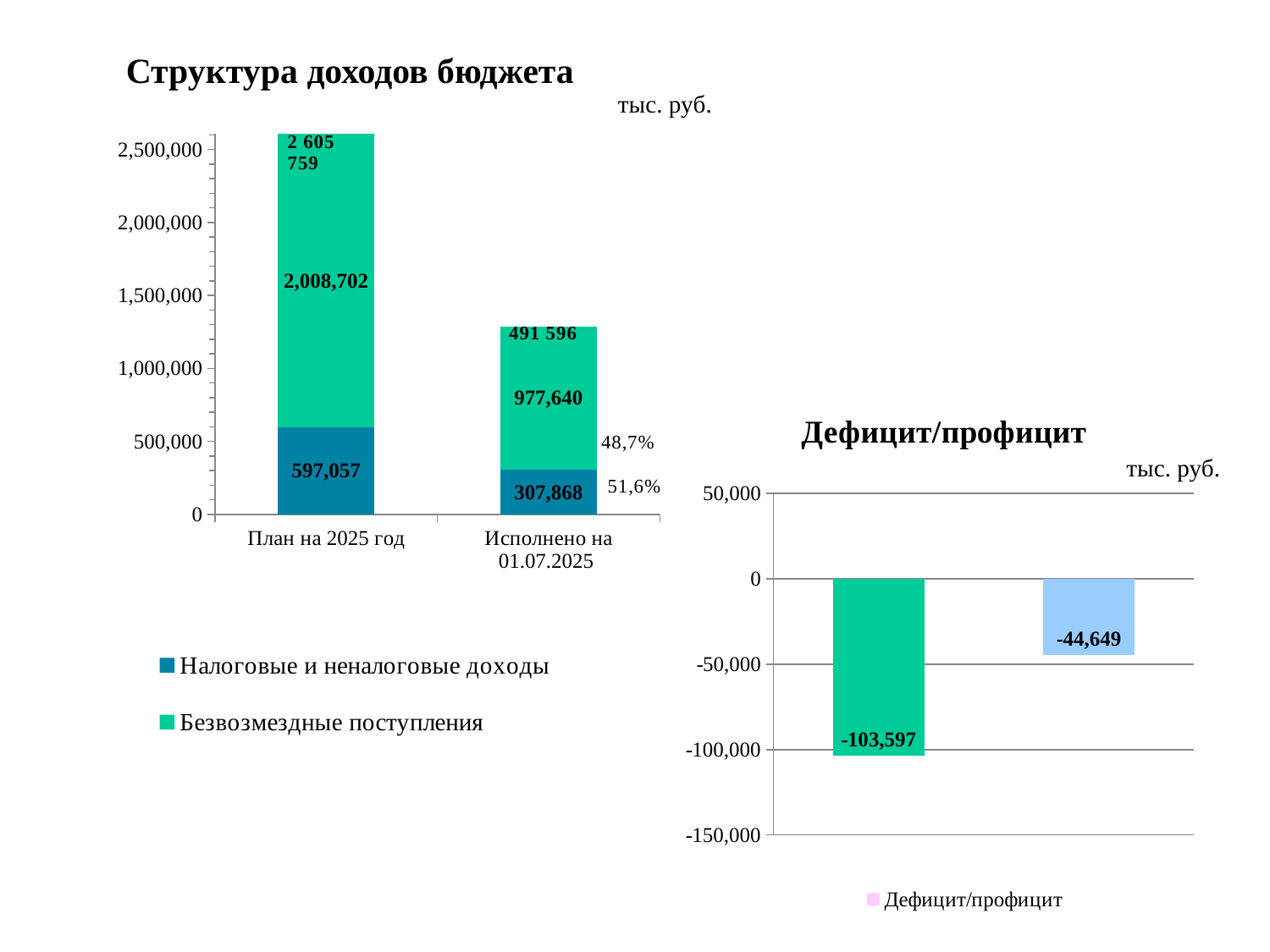
In the chart 'Структура доходов бюджета', what is the value of 'Налоговые и неналоговые доходы' for 'План на 2025 год'? 597,057 In the chart 'Структура доходов бюджета', what is the difference between 'Безвозмездные поступления' for 'План на 2025 год' and for 'Исполнено на 01.07.2025'? 1,031,062 In the chart 'Структура доходов бюджета', what is the total printed above the 'План на 2025 год' bar? 2 605 759 In the chart 'Дефицит/профицит', what is the value of the right (light blue) bar? -44,649 In the chart 'Структура доходов бюджета', what is the value of 'Безвозмездные поступления' for 'План на 2025 год'? 2,008,702 In the chart 'Структура доходов бюджета', what is the difference between 'Налоговые и неналоговые доходы' for 'План на 2025 год' and for 'Исполнено на 01.07.2025'? 289,189 In the chart 'Структура доходов бюджета', what is the value of 'Безвозмездные поступления' for 'Исполнено на 01.07.2025'? 977,640 In the chart 'Структура доходов бюджета', which series has the larger value for 'План на 2025 год'? Безвозмездные поступления How many series does the legend of the chart 'Структура доходов бюджета' list? 2 In the chart 'Дефицит/профицит', what is the value of the left (green) bar? -103,597 What kind of chart is 'Структура доходов бюджета'? Stacked bar chart In the chart 'Структура доходов бюджета', what is the value of 'Налоговые и неналоговые доходы' for 'Исполнено на 01.07.2025'? 307,868